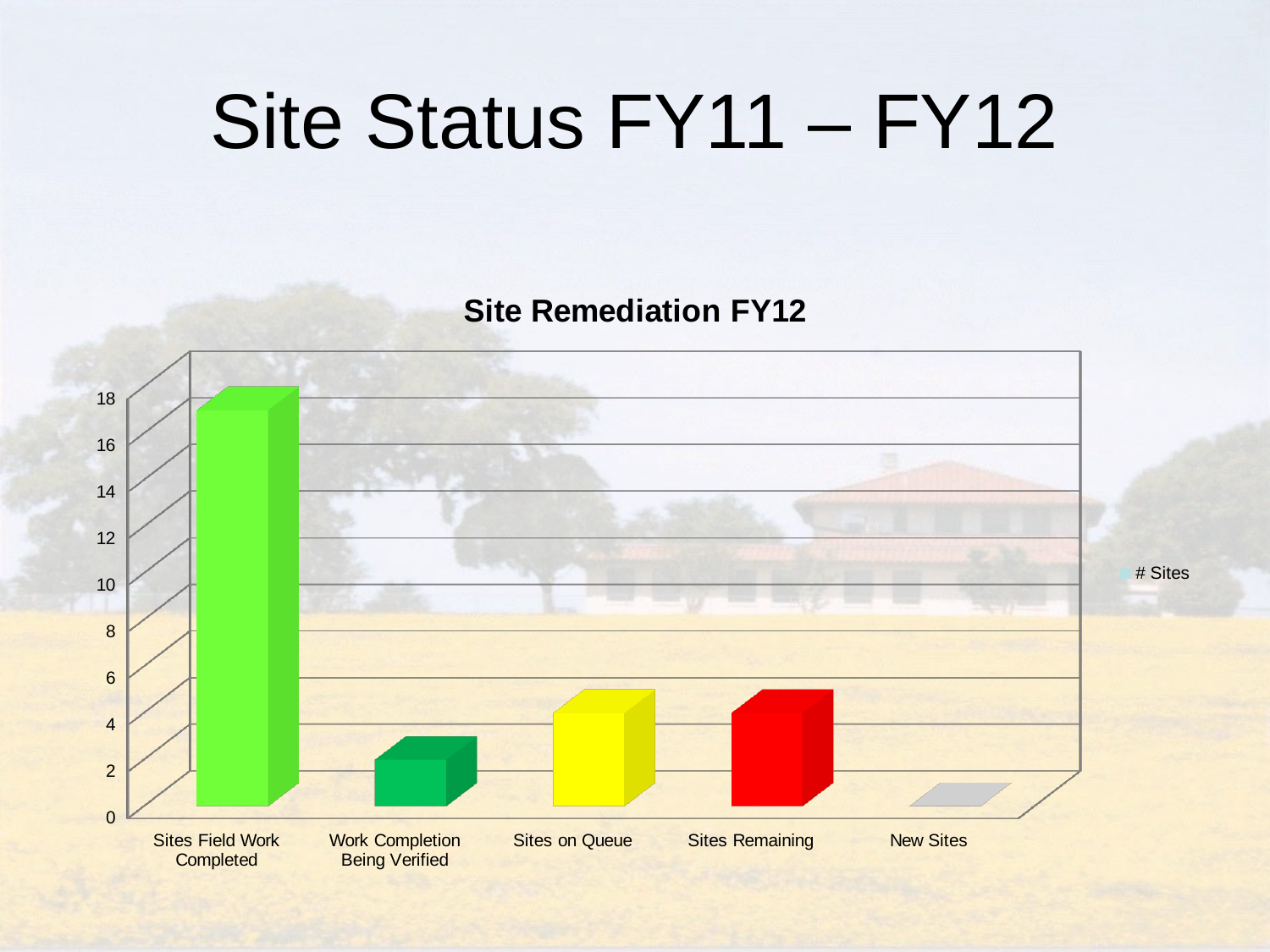
Which category has the highest value in the chart? Sites Field Work Completed How many series does the chart's legend list? 1 Is the value for Sites Field Work Completed greater or less than 10? greater What type of chart is shown on the slide? Bar chart Is the value for Sites Remaining greater or less than 2? greater What is the title of the chart? Site Remediation FY12 Which is larger, the value for Sites Field Work Completed or the value for Work Completion Being Verified? Sites Field Work Completed What is the name of the series listed in the chart's legend? # Sites Is the value for Sites on Queue greater or less than 8? less How many categories are shown on the x axis of the chart? 5 Which category has the lowest value in the chart? New Sites